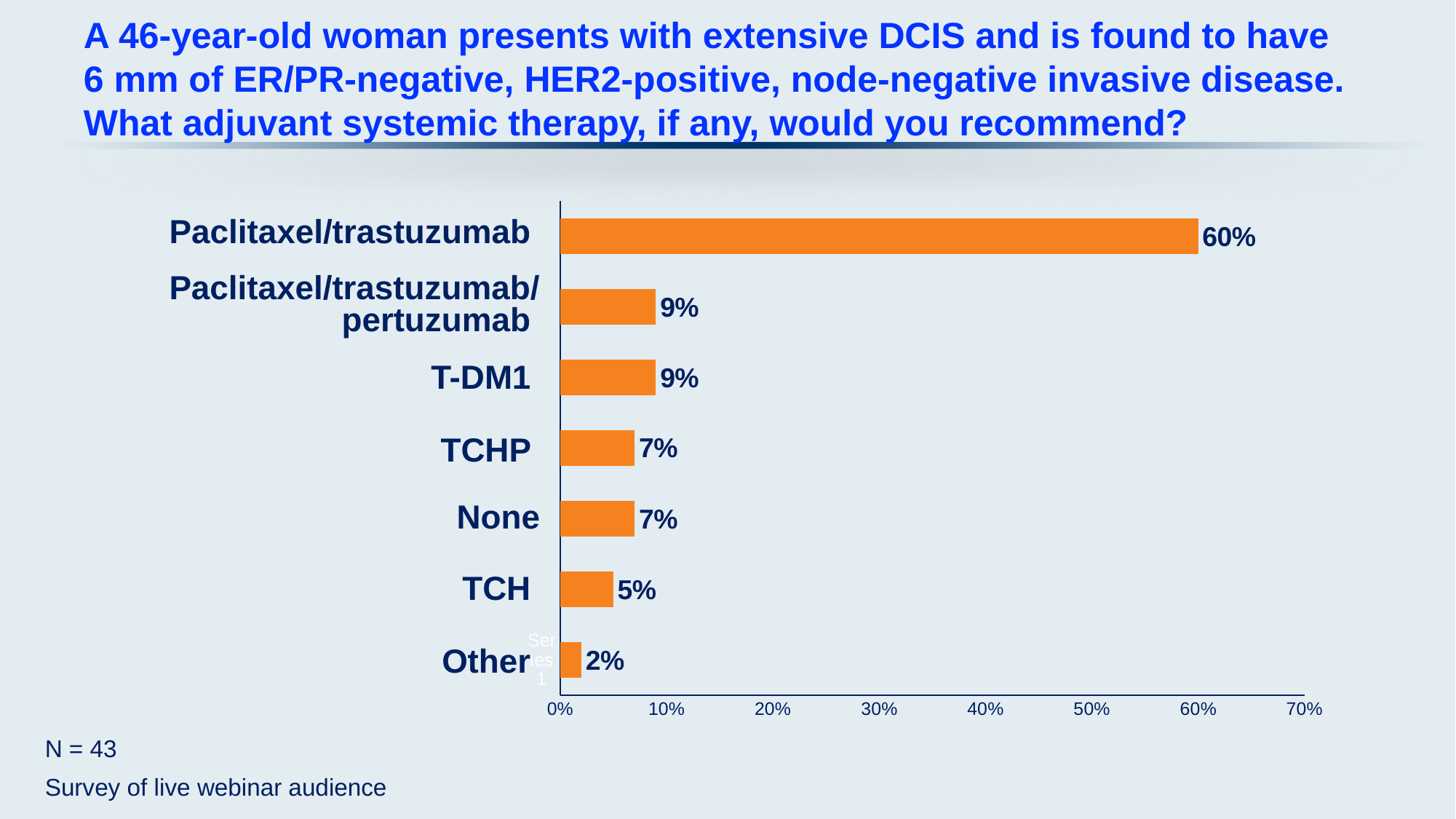
What percentage of respondents recommended T-DM1? 9% Which option received the highest percentage of responses? Paclitaxel/trastuzumab What percentage of respondents recommended Paclitaxel/trastuzumab? 60% How many response options are shown in the chart? 7 What is the difference in percentage points between TCHP and TCH? 2 What percentage of respondents recommended TCH? 5% What is the difference in percentage points between Paclitaxel/trastuzumab and Paclitaxel/trastuzumab/pertuzumab? 51 Which received a larger share of responses, TCHP or Other? TCHP What percentage of respondents chose None? 7% Which option received the lowest percentage of responses? Other What type of chart is shown on the slide? Bar chart What is the maximum value shown on the horizontal axis? 70%